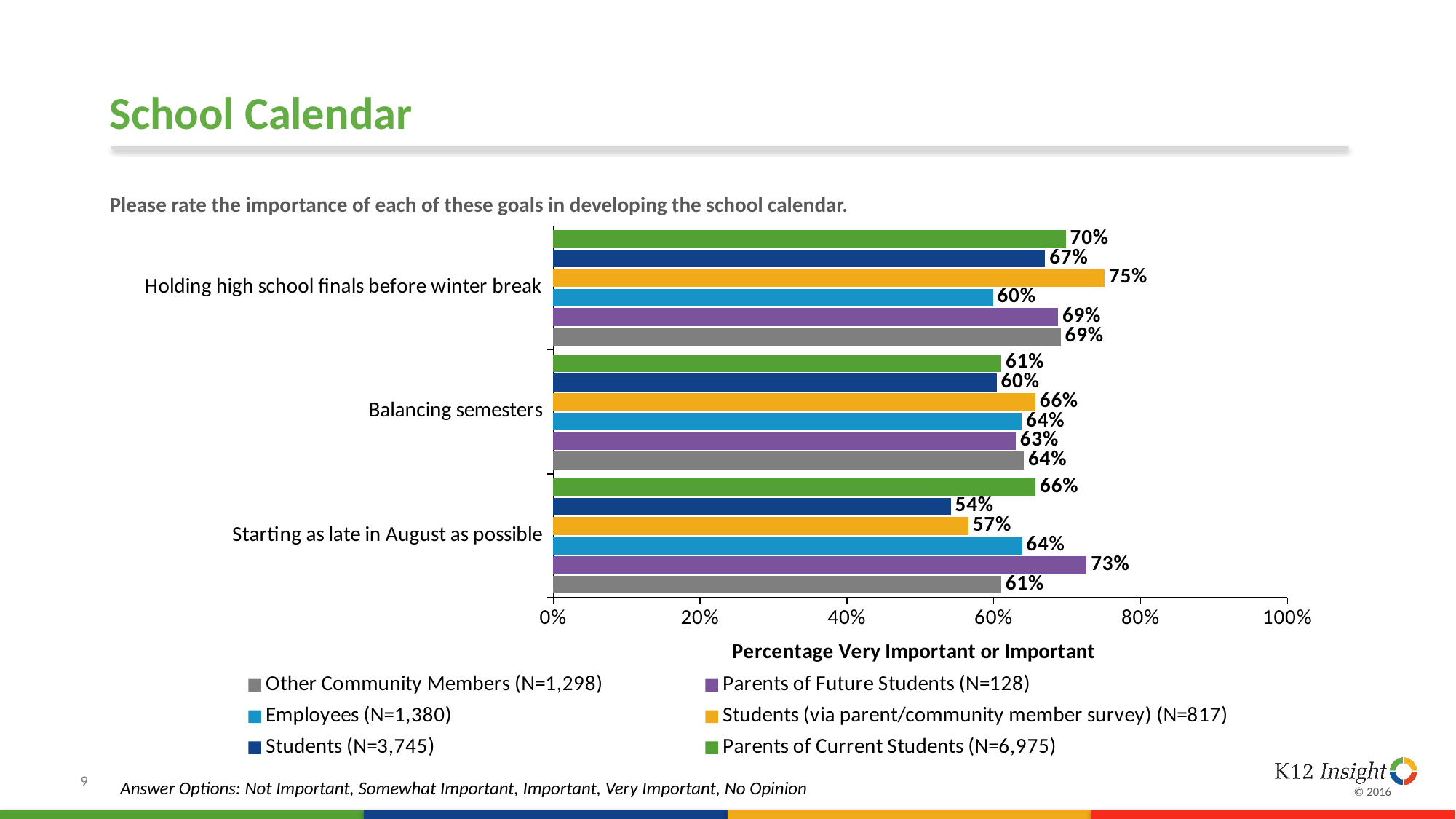
What is the label of the horizontal axis? Percentage Very Important or Important What is the value for Parents of Current Students on 'Balancing semesters'? 61% For 'Balancing semesters', which is larger: the value for Students (via parent/community member survey) or the value for Students? Students (via parent/community member survey) Which group has the lowest value for 'Starting as late in August as possible'? Students (N=3,745) What is the difference between the Parents of Future Students value and the Students value for 'Starting as late in August as possible'? 19% Which group has the highest value for 'Starting as late in August as possible'? Parents of Future Students (N=128) What kind of chart is shown on the slide? Bar chart Which group has the lowest value for 'Holding high school finals before winter break'? Employees (N=1,380) What percentage of Students (via parent/community member survey) rated 'Holding high school finals before winter break' as very important or important? 75% What is the value for Employees on 'Starting as late in August as possible'? 64% How many goal categories are shown on the chart? 3 How many series does the legend list? 6